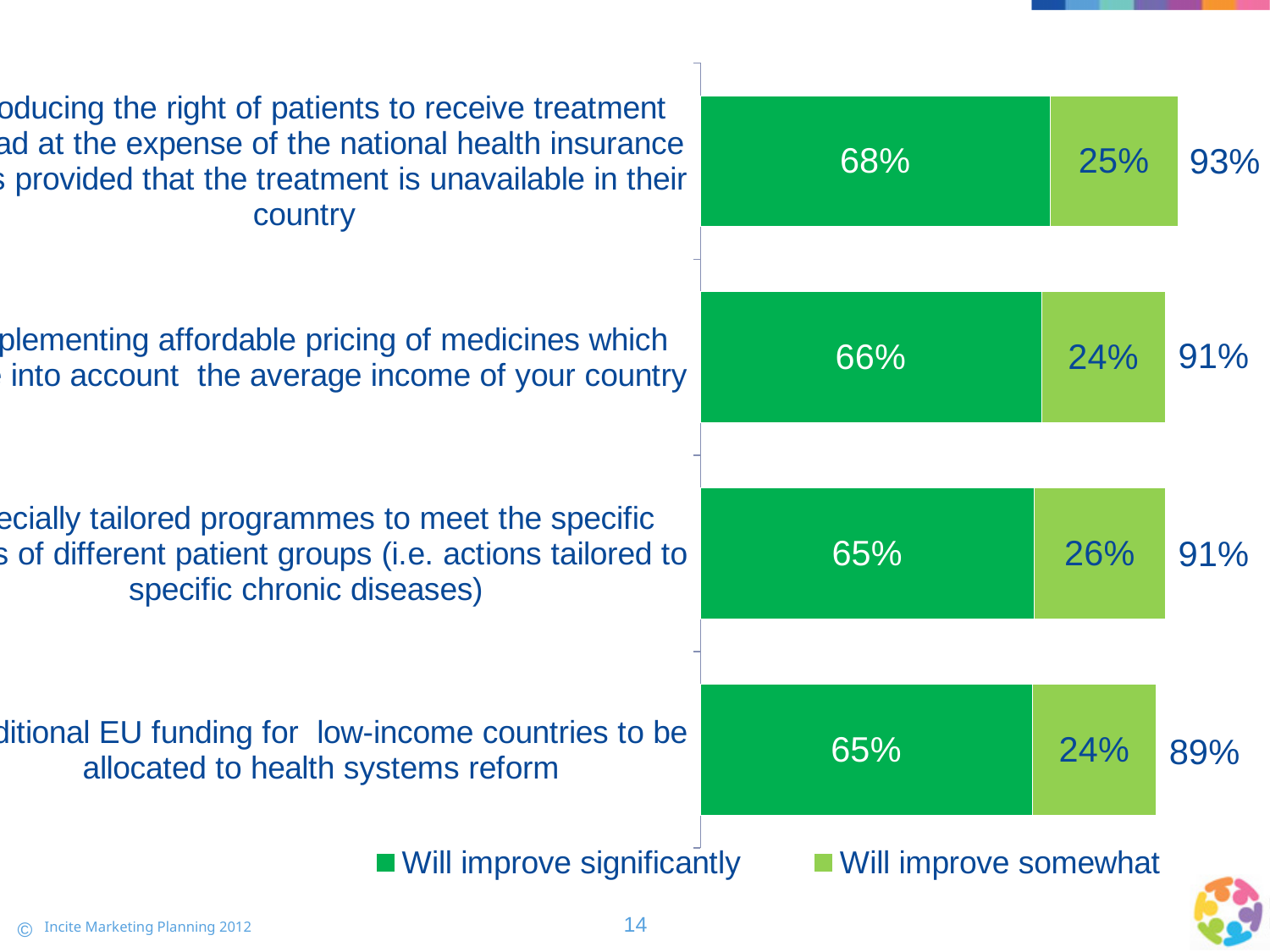
What is the combined total for the measure on specially tailored programmes to meet the specific needs of different patient groups? 91% Which measure has the highest 'Will improve significantly' percentage? The right of patients to receive treatment abroad at the expense of the national health insurance (68%) How many series does the legend list? 2 What is the difference between the 'Will improve significantly' values for the treatment-abroad measure (68%) and the additional EU funding measure (65%)? 3 percentage points What percentage of respondents said the measure on affordable pricing of medicines taking into account the average income of the country 'Will improve significantly'? 66% What type of chart is shown on the slide? Stacked bar chart What are the two legend entries in the chart? Will improve significantly; Will improve somewhat What is the 'Will improve significantly' value for the measure on the right of patients to receive treatment abroad at the expense of the national health insurance? 68% Which has a larger 'Will improve somewhat' value: the tailored programmes for specific patient groups measure or the affordable pricing of medicines measure? Tailored programmes for specific patient groups (26%) What is the 'Will improve somewhat' value for the measure on additional EU funding for low-income countries to be allocated to health systems reform? 24% Which measure has the lowest combined total shown at the end of its bar? Additional EU funding for low-income countries to be allocated to health systems reform (89%) How many measures (bars) are shown in the chart? 4